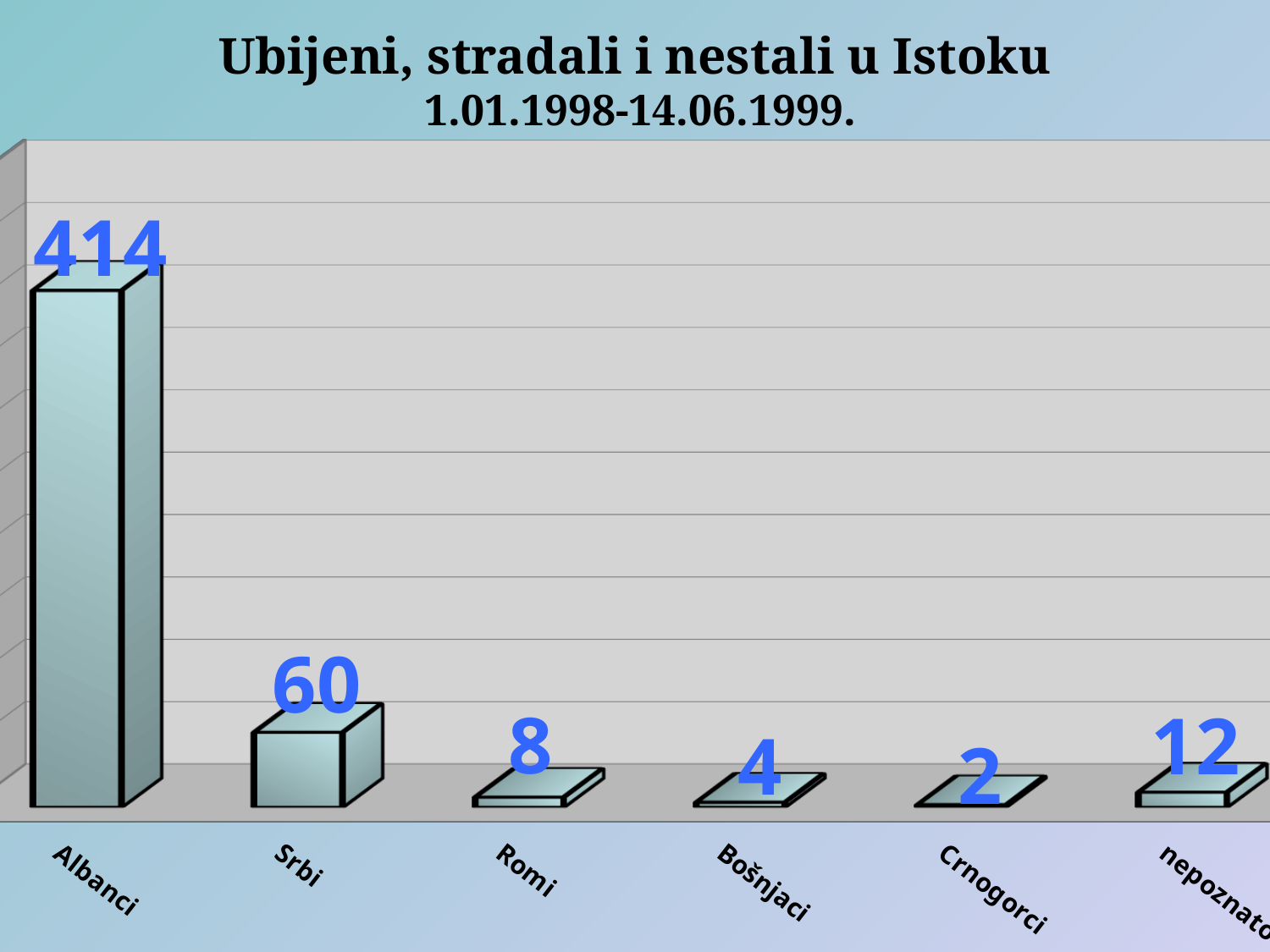
Which category has the lowest value? Crnogorci Which is larger, the value for Romi or the value for nepoznato? nepoznato What is the value for nepoznato? 12 Which category has the highest value? Albanci What is the value for Srbi? 60 What is the value for Bošnjaci? 4 What is the difference between the values for Albanci and Srbi? 354 How many categories are shown in the chart? 6 What kind of chart is shown on the slide? bar chart What is the value for Albanci? 414 What is the value for Romi? 8 What is the title of the chart? Ubijeni, stradali i nestali u Istoku 1.01.1998-14.06.1999.